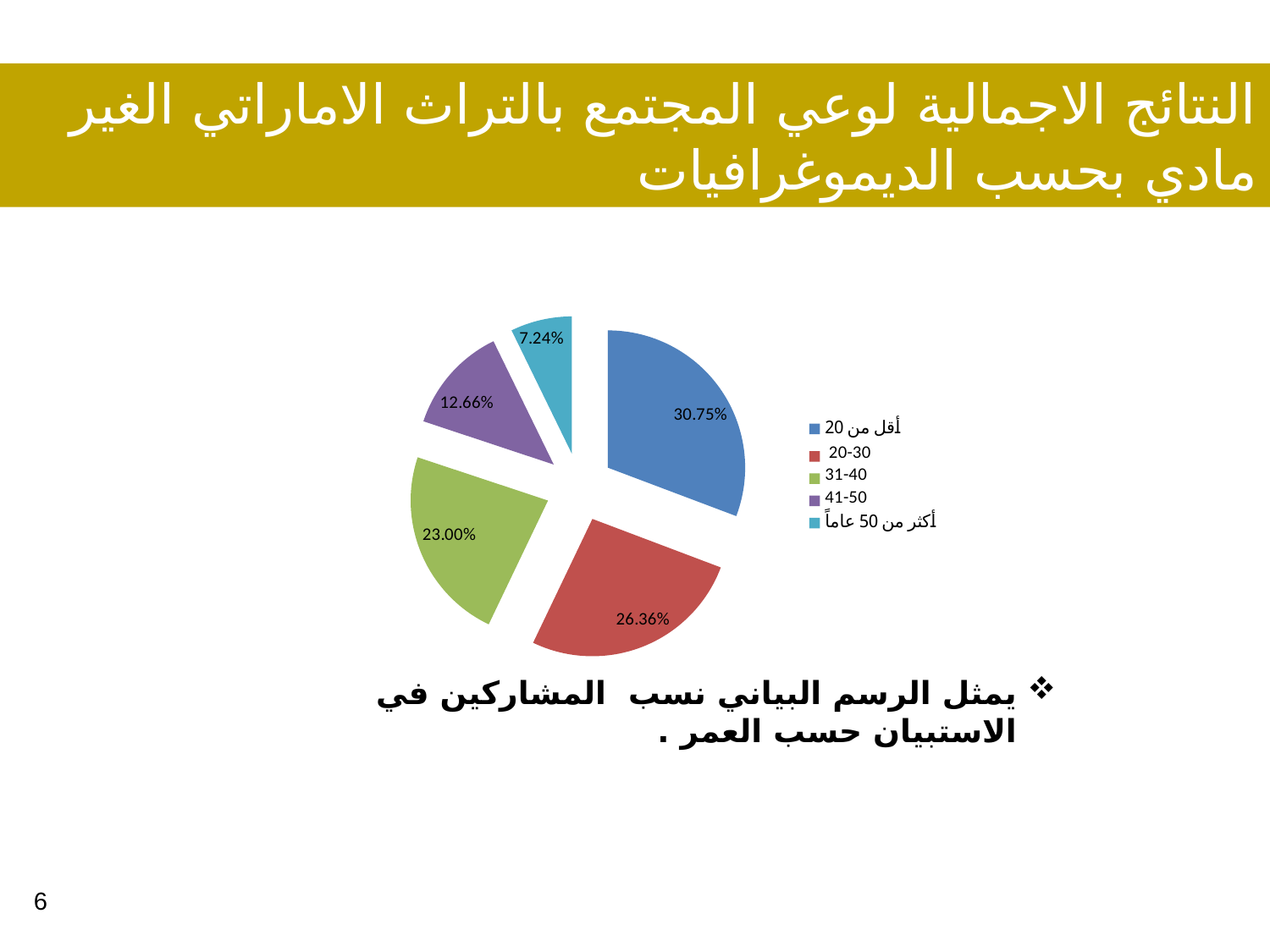
What is the difference in percentage points between the "أقل من 20" slice and the "أكثر من 50 عاماً" slice? 23.51 What kind of chart is shown on the slide? pie chart How many slices does the pie chart have? 5 What percentage of the pie is the slice for "41-50"? 12.66% Which age group has the smallest share of the pie? أكثر من 50 عاماً Which is larger, the share for "20-30" or the share for "31-40"? 20-30 What percentage of the pie is the slice for "31-40"? 23.00% What percentage of the pie is the slice for "أقل من 20"? 30.75% Which age group has the largest share of the pie? أقل من 20 What colour is the slice for "41-50" in the pie chart? purple What percentage of the pie is the slice for "أكثر من 50 عاماً"? 7.24% What percentage of the pie is the slice for "20-30"? 26.36%